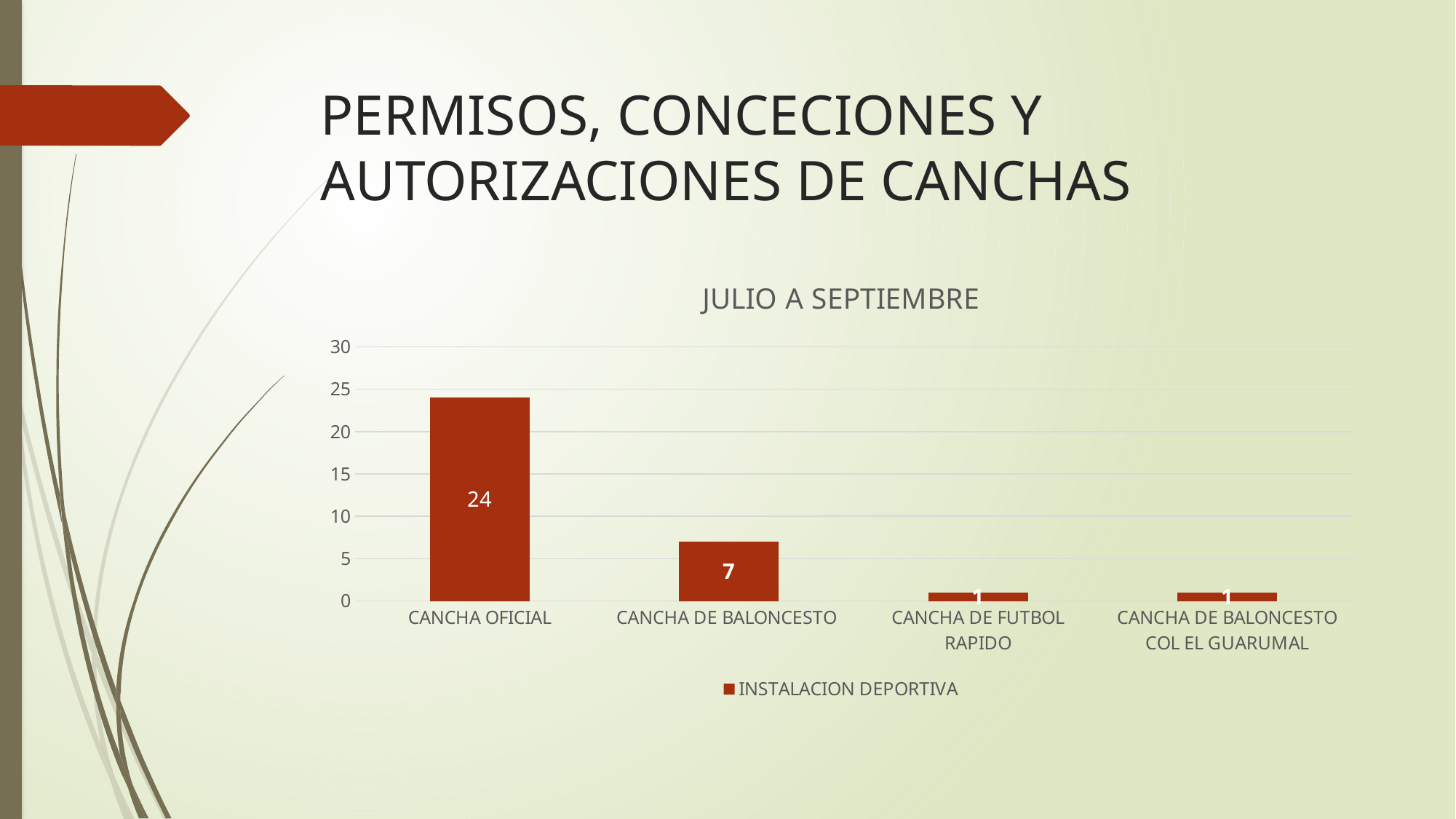
Which category has the highest value? CANCHA OFICIAL What is the title of the chart? JULIO A SEPTIEMBRE Is the value for CANCHA OFICIAL greater or less than 20? greater Which is larger, the value for CANCHA DE BALONCESTO or the value for CANCHA DE FUTBOL RAPIDO? CANCHA DE BALONCESTO What kind of chart is shown on the slide? bar chart What is the value for CANCHA DE FUTBOL RAPIDO? 1 How many series does the legend list? 1 How many categories are shown on the x axis? 4 What is the difference between the values for CANCHA OFICIAL and CANCHA DE BALONCESTO? 17 What is the value for CANCHA DE BALONCESTO? 7 What series name is shown in the legend? INSTALACION DEPORTIVA What is the value for CANCHA OFICIAL? 24